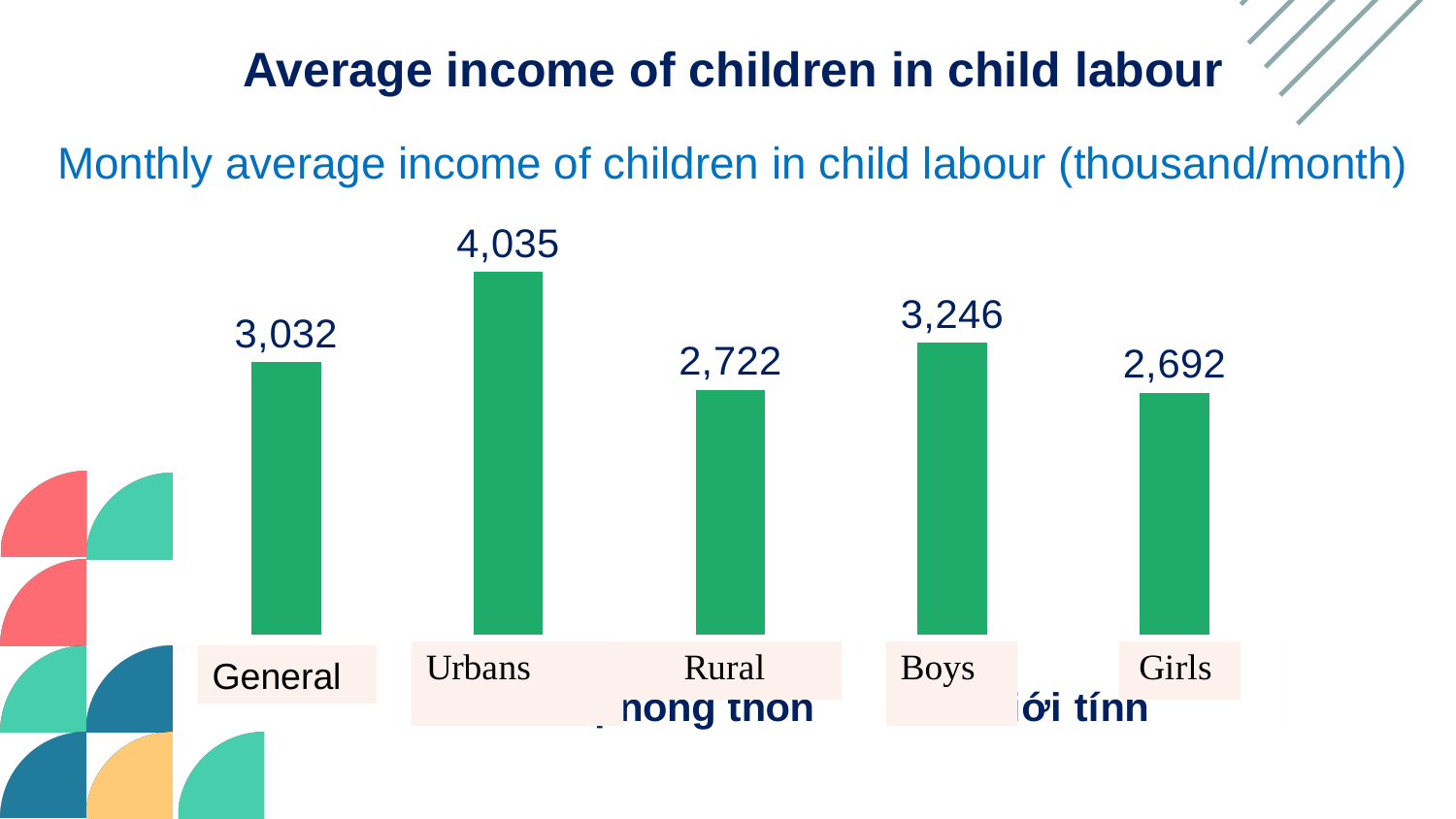
What is the monthly average income for Boys? 3,246 What kind of chart is shown on the slide? Bar chart What is the difference between the monthly average income of Boys and Girls? 554 What is the monthly average income for Urbans? 4,035 What is the difference between the monthly average income of Urbans and Rural? 1,313 How many categories are shown in the chart? 5 Which category has the highest monthly average income? Urbans Which category has the lowest monthly average income? Girls Which is larger, the monthly average income of Boys or of General? Boys What is the monthly average income for Girls? 2,692 What is the monthly average income for Rural? 2,722 What is the monthly average income for the General category? 3,032